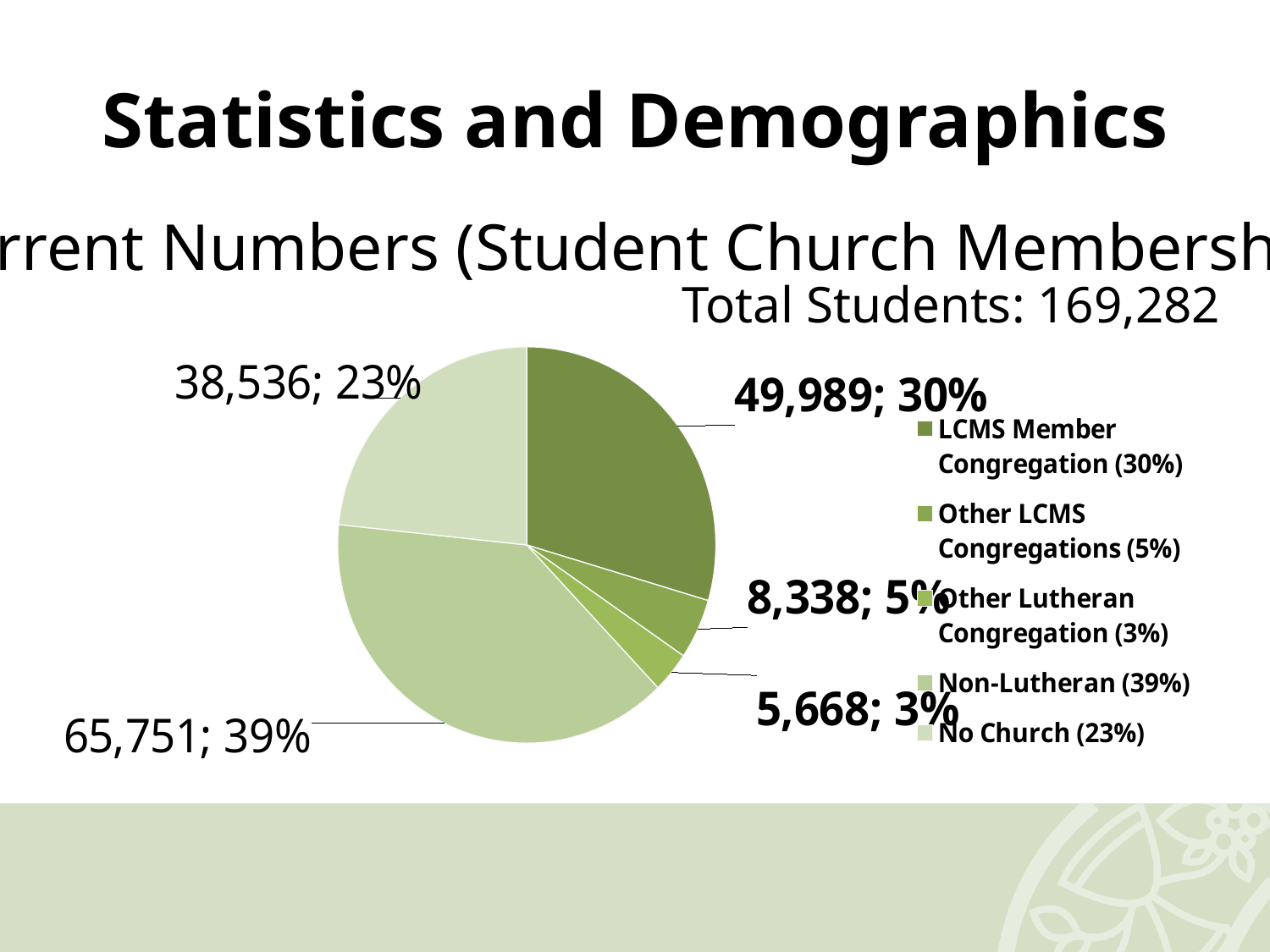
What is the number of students in the Non-Lutheran slice? 65,751 What is the number of students in the Other Lutheran Congregation slice? 5,668 How many slices does the pie chart have? 5 Which is larger, the No Church slice or the LCMS Member Congregation slice? LCMS Member Congregation What is the number of students in the LCMS Member Congregation slice? 49,989 What kind of chart is shown on the slide? Pie chart What is the difference in students between the Non-Lutheran slice and the LCMS Member Congregation slice? 15,762 How many entries does the legend of the pie chart list? 5 Which category has the largest slice of the pie? Non-Lutheran What share of the pie does the Other LCMS Congregations slice represent? 5% What is the number of students in the No Church slice? 38,536 Which category has the smallest slice of the pie? Other Lutheran Congregation